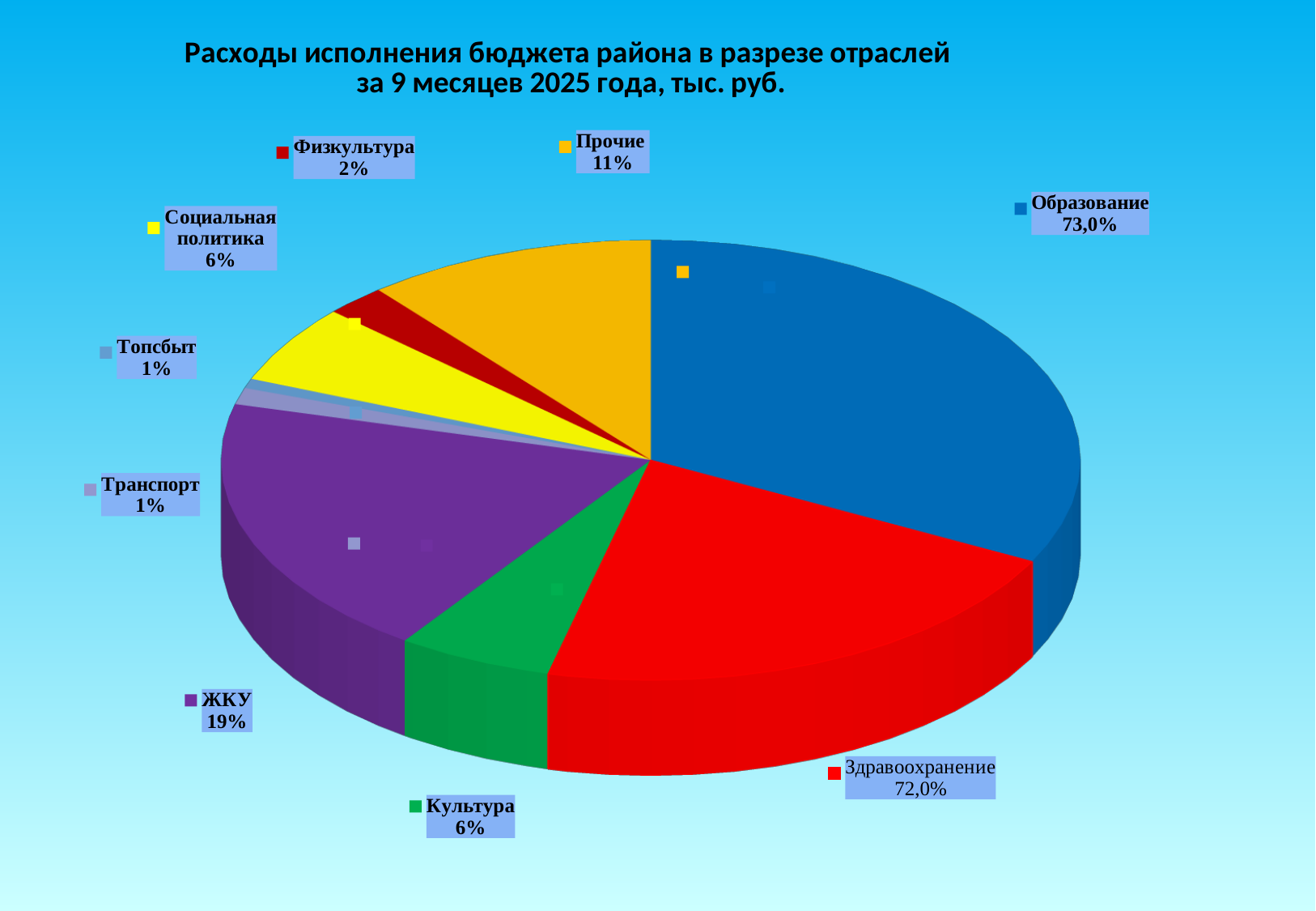
What percentage is shown for ЖКУ? 19% What share of the pie is labelled for Образование? 73,0% What is the title of the chart? Расходы исполнения бюджета района в разрезе отраслей за 9 месяцев 2025 года, тыс. руб. What kind of chart is shown on the slide? pie chart What percentage is shown for Топсбыт? 1% By how many percentage points does the share for ЖКУ exceed the share for Прочие? 8 Which category has the largest slice of the pie? Образование What percentage is shown for Социальная политика? 6% What percentage is shown for Прочие? 11% What percentage is shown for Физкультура? 2% How many categories are shown in the pie chart? 9 Which is larger, the share for ЖКУ or the share for Прочие? ЖКУ